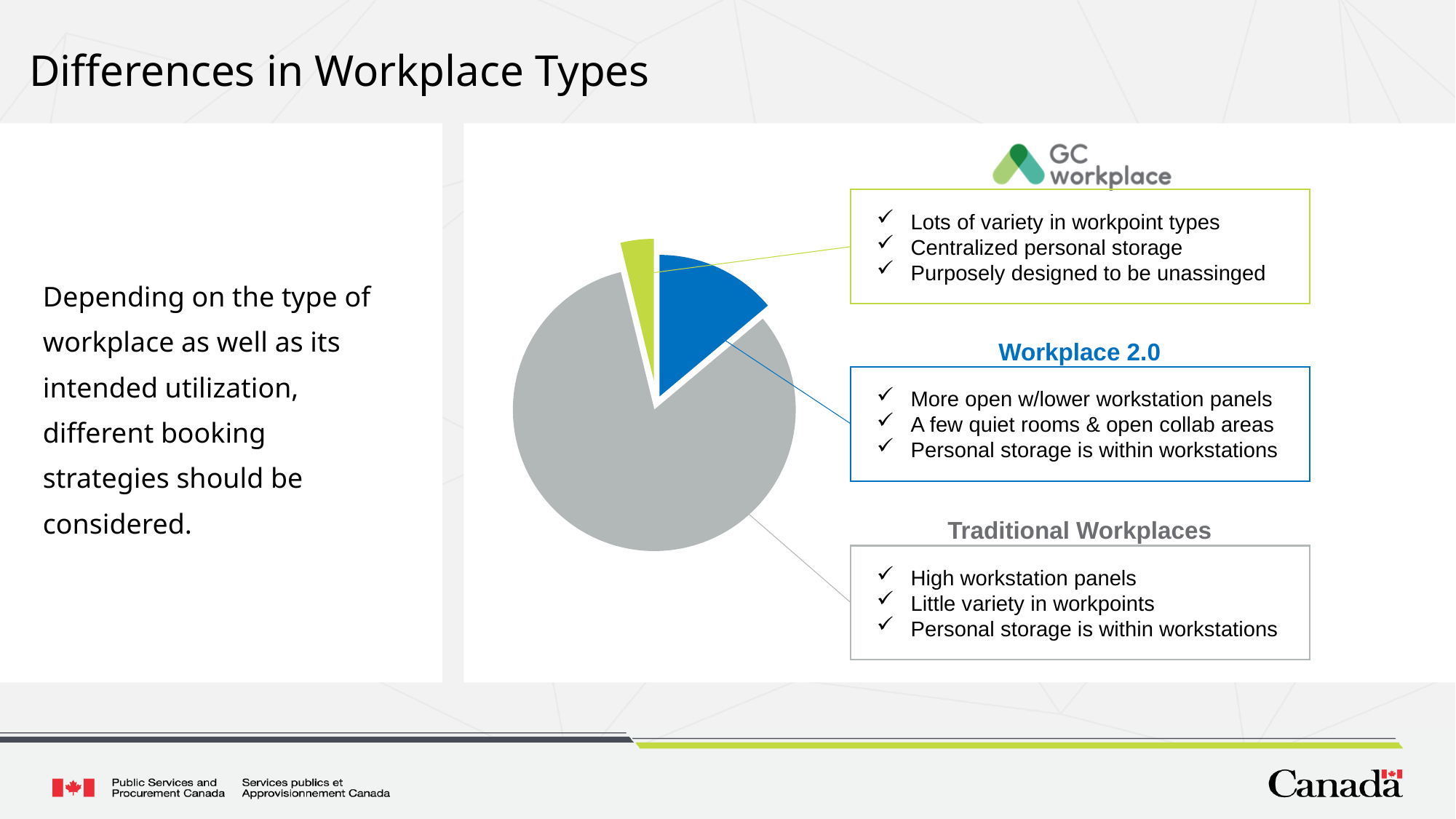
Which slice is larger in the pie chart, GC workplace or Workplace 2.0? Workplace 2.0 What kind of chart is shown on the slide? pie chart How many slices does the pie chart have? 3 Does the Traditional Workplaces slice take up more or less than half of the pie chart? more What colour is the slice representing Workplace 2.0 in the pie chart? blue Which slice is larger in the pie chart, Workplace 2.0 or Traditional Workplaces? Traditional Workplaces Which workplace type has the largest slice of the pie chart? Traditional Workplaces What colour is the slice representing Traditional Workplaces in the pie chart? grey Which workplace type has the smallest slice of the pie chart? GC workplace